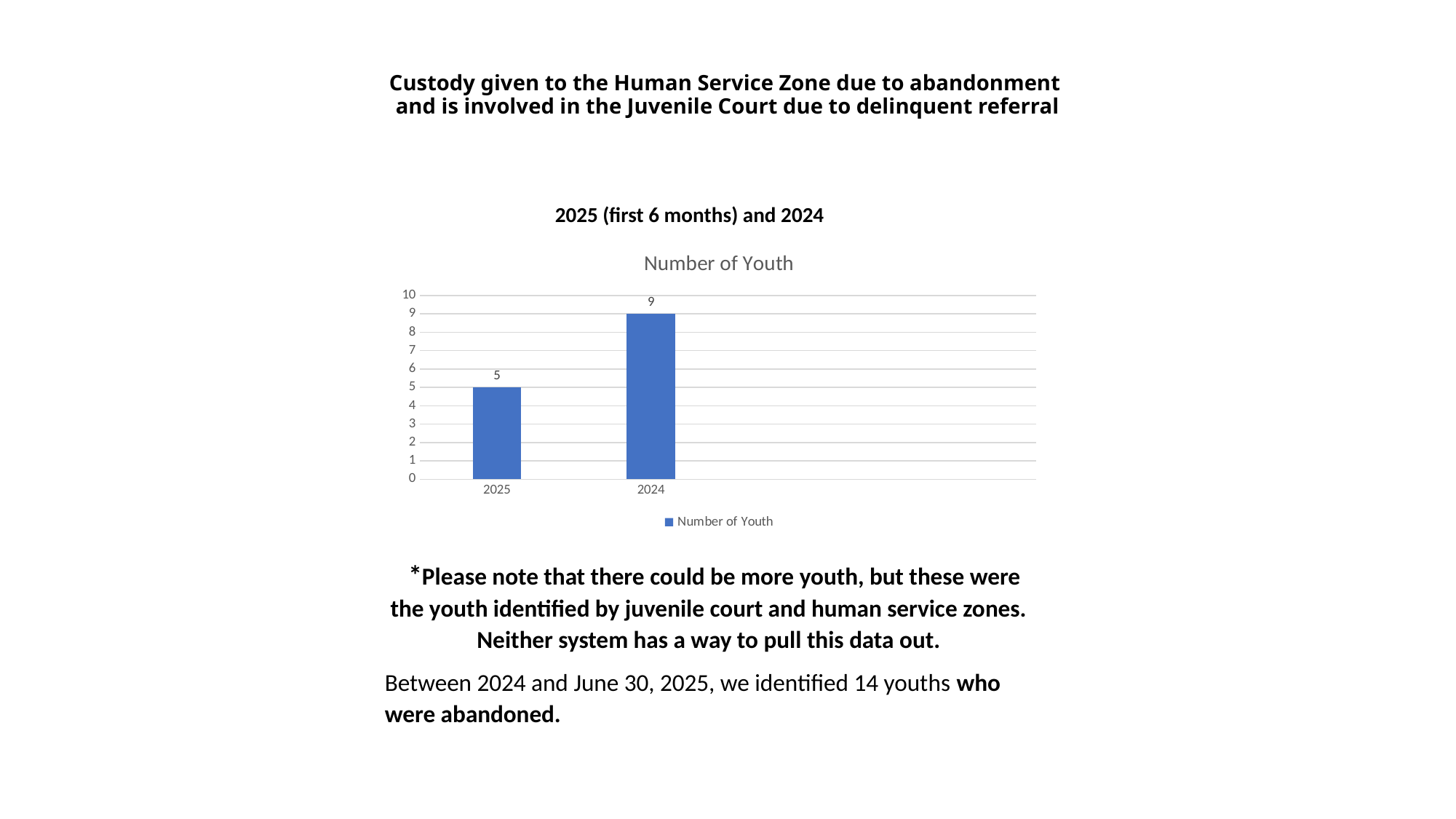
What is the number of youth for 2025? 5 What is the number of youth for 2024? 9 What is the title of the chart? Number of Youth Which year has the lowest number of youth? 2025 What is the difference between the number of youth in 2024 and 2025? 4 Which year has the highest number of youth? 2024 What is the total number of youth across 2025 and 2024 combined? 14 How many categories are shown on the x axis of the chart? 2 Which is larger, the number of youth in 2025 or in 2024? 2024 How many series does the chart legend list? 1 What kind of chart is shown on the slide? bar chart Is the value for 2024 greater or less than 8? greater